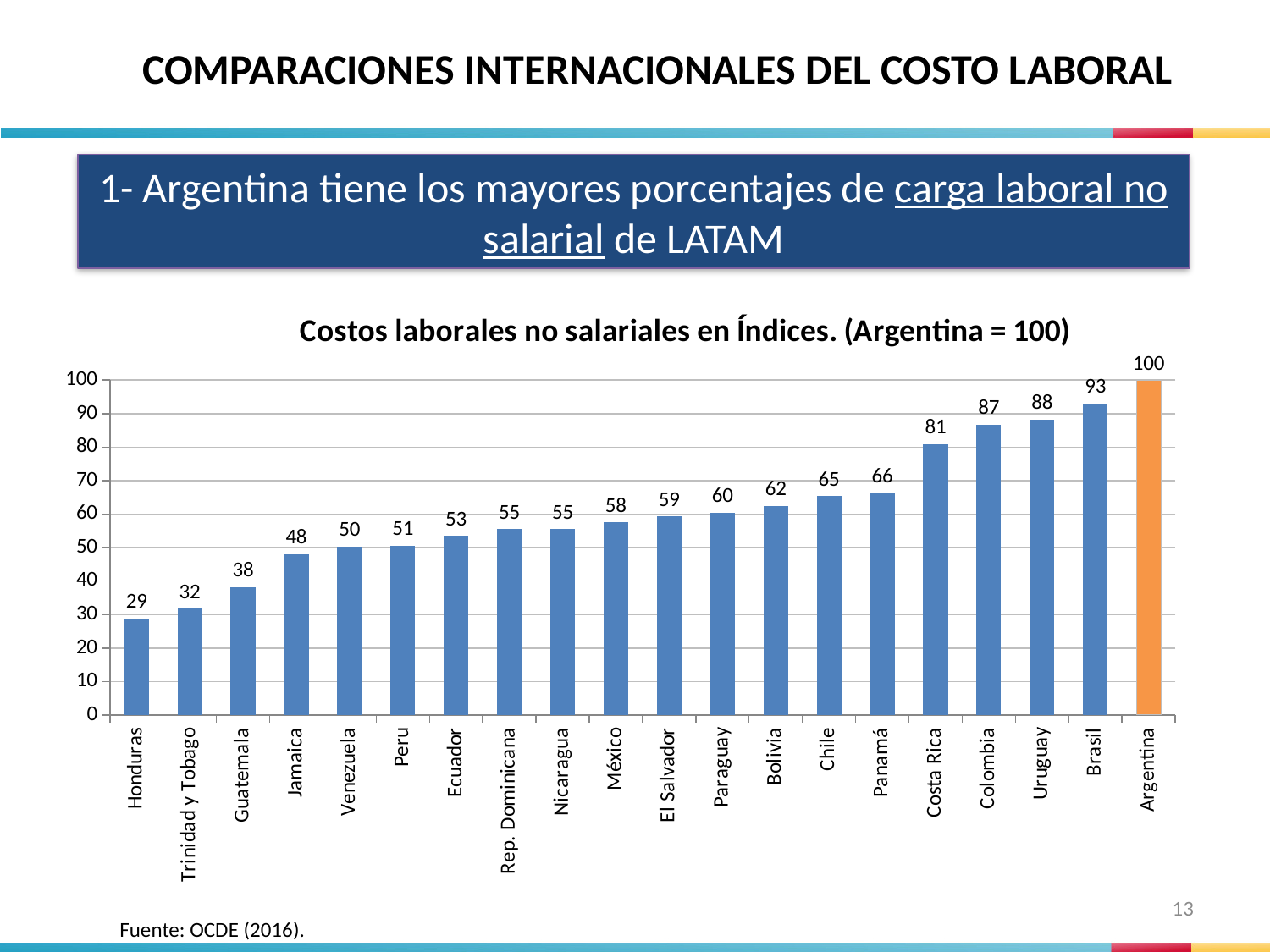
How many countries are shown in the chart? 20 Which country has the lowest value? Honduras Which country has the highest value? Argentina What is the title of the chart? Costos laborales no salariales en Índices. (Argentina = 100) Do the values rise or fall from left to right along the x axis? Rise What is the value for Costa Rica? 81 What kind of chart is shown on the slide? Bar chart What is the value for Guatemala? 38 Is the value for Bolivia greater or less than 70? less What is the value for Brasil? 93 Which has a larger value, Colombia or Panamá? Colombia What is the difference between the values for Uruguay and Chile? 23